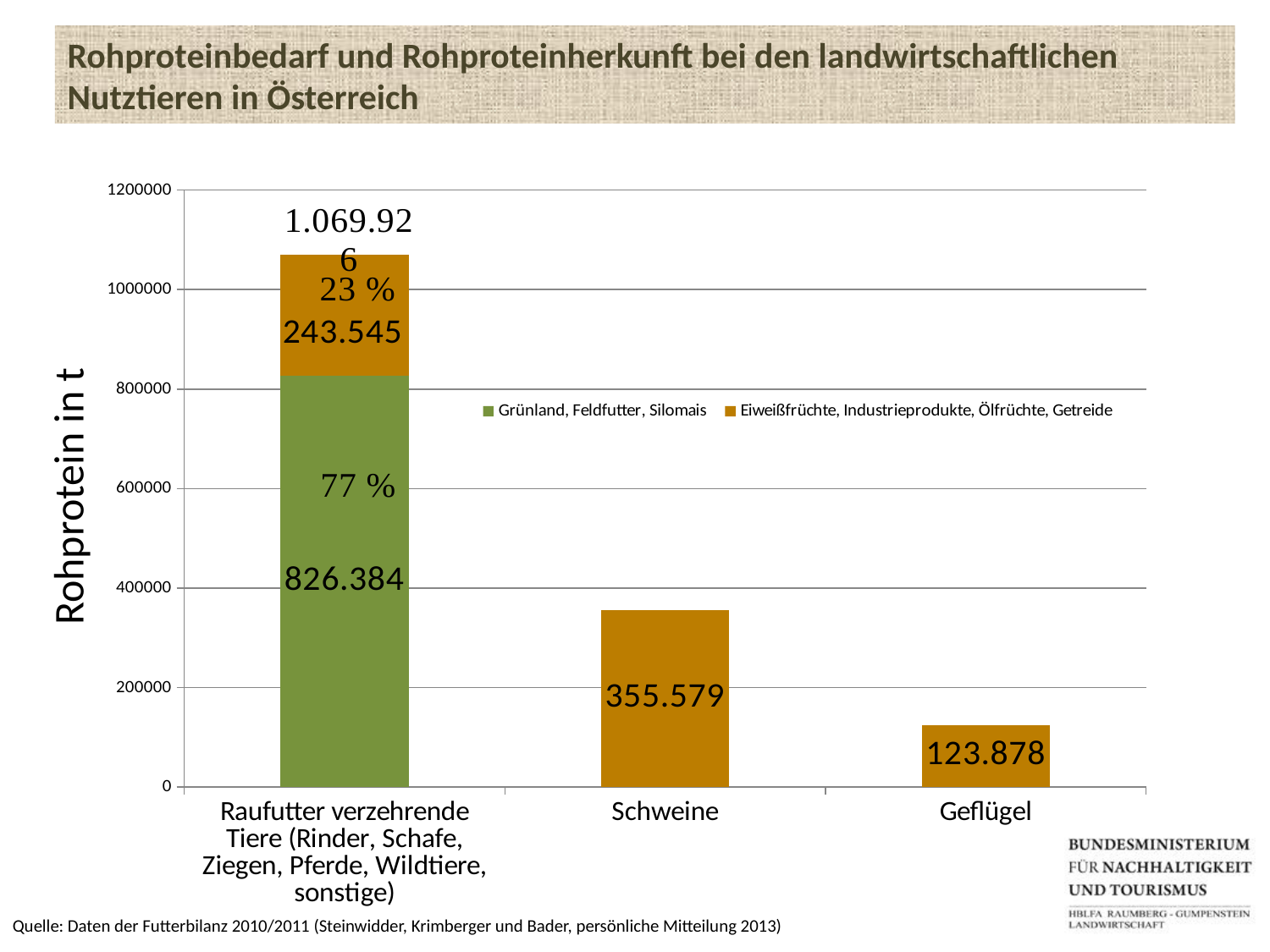
Which category has the lowest Rohprotein value? Geflügel How many categories are shown on the x axis? 3 What is the value shown for Geflügel? 123.878 What is the value shown for Schweine? 355.579 What is the difference between the values for Schweine and Geflügel? 231.701 Which category has the highest total Rohprotein? Raufutter verzehrende Tiere What is the value of Eiweißfrüchte, Industrieprodukte, Ölfrüchte, Getreide for Raufutter verzehrende Tiere? 243.545 What percentage of the Raufutter verzehrende Tiere bar comes from Grünland, Feldfutter, Silomais? 77 % Is the value for Schweine greater or less than 400000? less What is the title of the y axis? Rohprotein in t What is the value of Grünland, Feldfutter, Silomais for Raufutter verzehrende Tiere? 826.384 How many series does the legend list? 2